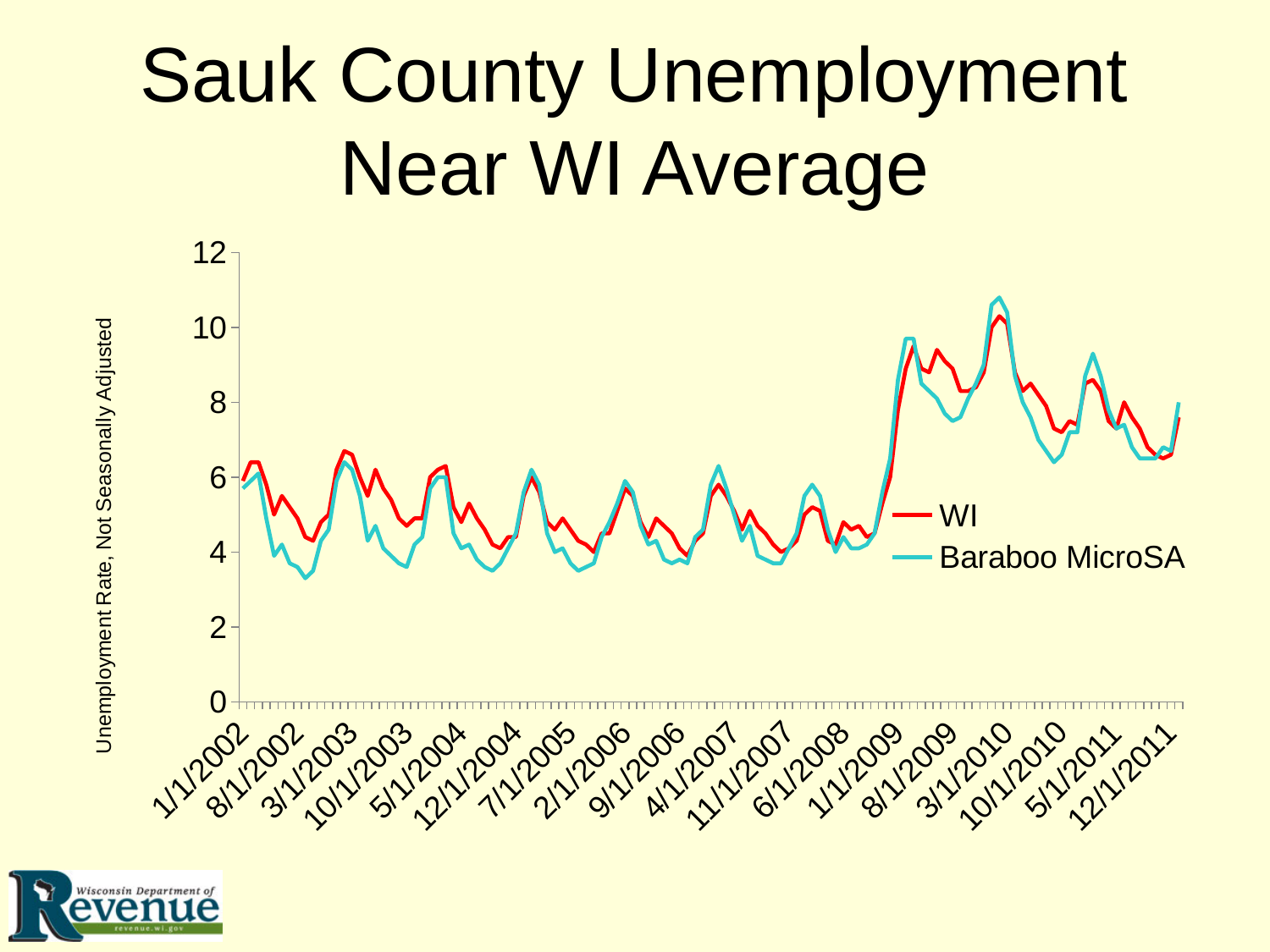
Is the Baraboo MicroSA value around 1/1/2009 greater or less than 8? greater At the low point around 3/1/2003, which series is higher, WI or Baraboo MicroSA? WI At the peak around 3/1/2010, which series is higher, WI or Baraboo MicroSA? Baraboo MicroSA How many series does the legend list? 2 What is the label on the vertical axis? Unemployment Rate, Not Seasonally Adjusted Between 6/1/2008 and 1/1/2009, do the unemployment rates rise or fall? rise Is the peak value of the Baraboo MicroSA series around 3/1/2010 greater or less than 10? greater Which series reaches the highest value anywhere on the chart? Baraboo MicroSA What kind of chart is shown on the slide? line chart What are the two series named in the legend? WI and Baraboo MicroSA Which series drops to the lowest value anywhere on the chart? Baraboo MicroSA